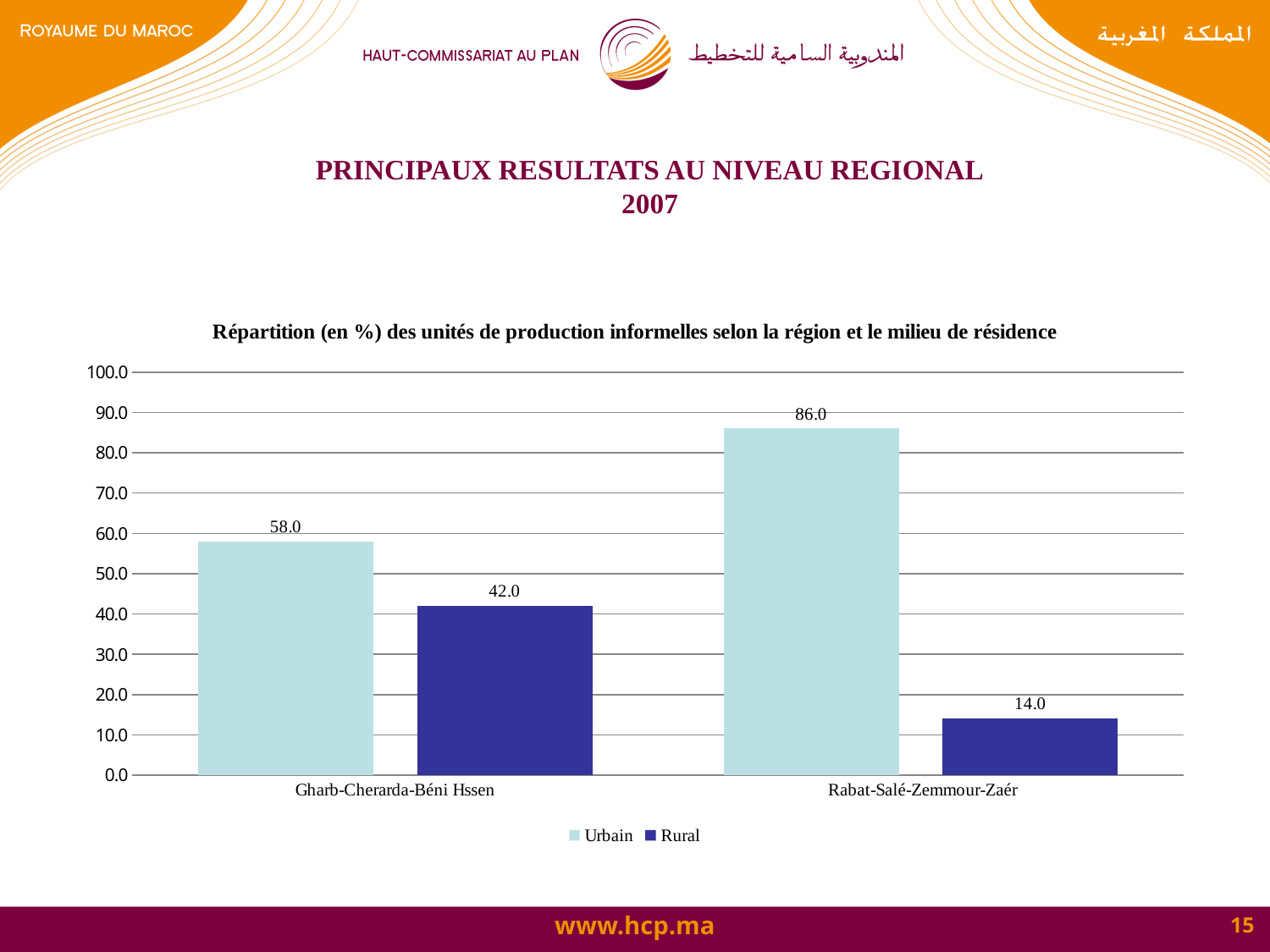
Which region has the lowest Rural value? Rabat-Salé-Zemmour-Zaér What is the difference between the Urbain and Rural values for Rabat-Salé-Zemmour-Zaér? 72.0 How many regions are shown on the x axis? 2 What is the Urbain value for Rabat-Salé-Zemmour-Zaér? 86.0 Which region has the highest Urbain value? Rabat-Salé-Zemmour-Zaér What is the Urbain value for Gharb-Cherarda-Béni Hssen? 58.0 What is the difference between the Urbain values for Rabat-Salé-Zemmour-Zaér and Gharb-Cherarda-Béni Hssen? 28.0 What is the Rural value for Gharb-Cherarda-Béni Hssen? 42.0 Which is larger for Gharb-Cherarda-Béni Hssen, the Urbain value or the Rural value? Urbain What kind of chart is shown on the slide? Bar chart What is the Rural value for Rabat-Salé-Zemmour-Zaér? 14.0 How many series does the legend list? 2